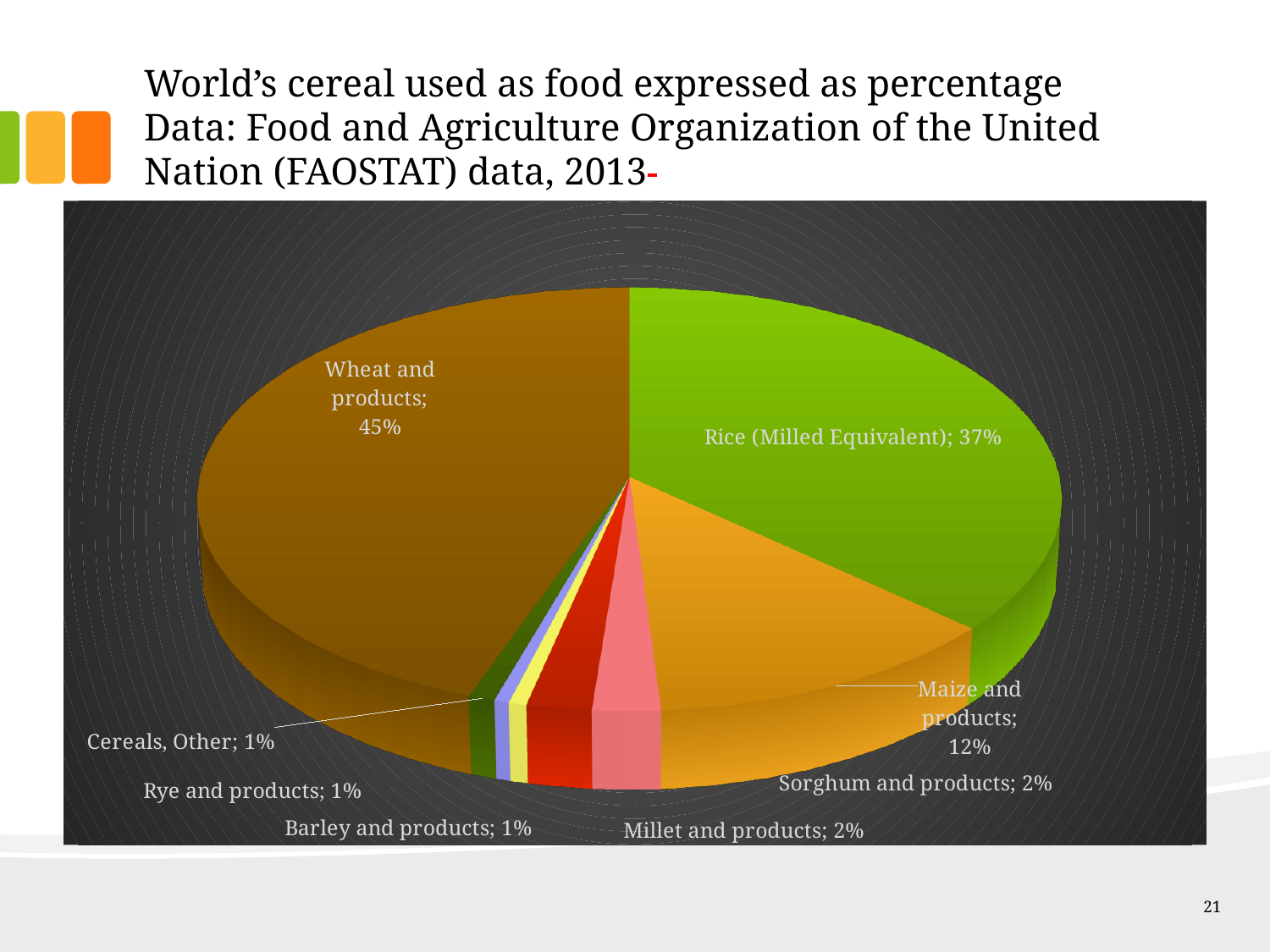
What is the value for Barley and products? 1% What is the value shown for Maize and products? 12% What is the difference in percentage points between Wheat and products and Rice (Milled Equivalent)? 8 What is the difference between the Rice (Milled Equivalent) share and the Maize and products share? 25 What percentage of the world's cereal used as food is Wheat and products? 45% How many categories (slices) are labelled in the pie chart? 8 What share does Rice (Milled Equivalent) have in the pie chart? 37% What percentage is shown for Sorghum and products? 2% Which is larger, the share for Maize and products or the share for Millet and products? Maize and products What is the source of the data cited in the slide title? Food and Agriculture Organization of the United Nation (FAOSTAT) data, 2013 Which category has the largest slice of the pie? Wheat and products What kind of chart is shown on the slide? pie chart